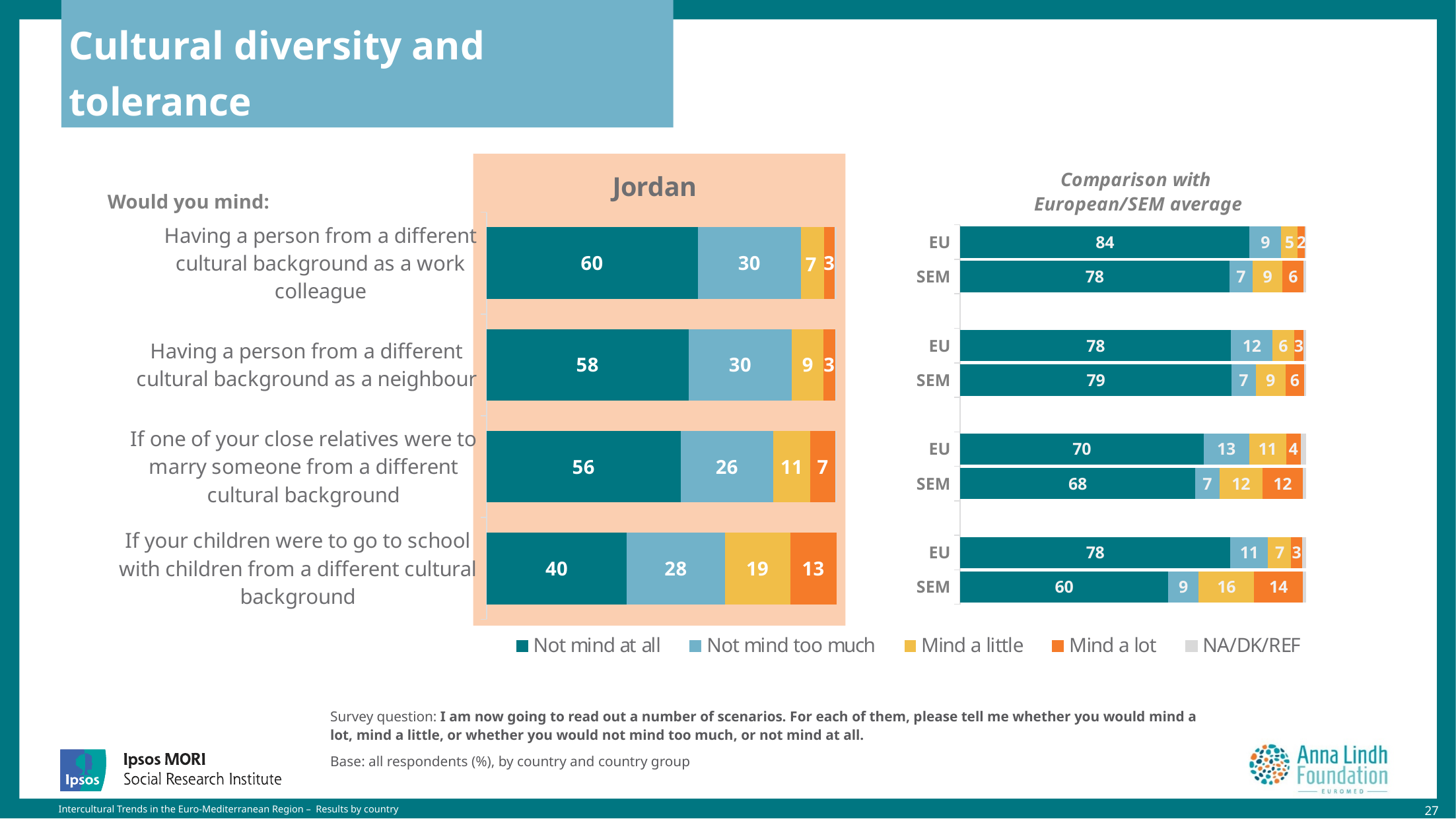
In the Jordan chart, what is the difference between the 'Not mind at all' values for the work colleague scenario and the children at school scenario? 20 In the Jordan chart, which scenario has the highest 'Not mind at all' value? Having a person from a different cultural background as a work colleague How many series does the legend list? 5 In the Jordan chart, what percentage would 'Not mind at all' having a person from a different cultural background as a work colleague? 60 In the Comparison with European/SEM average chart, what is the difference between the EU and SEM 'Not mind at all' values for the work colleague scenario? 6 What kind of chart is the Jordan chart? Stacked bar chart In the Jordan chart, which scenario has the lowest 'Not mind at all' value? If your children were to go to school with children from a different cultural background In the Jordan chart, what is the 'Mind a lot' value for children going to school with children from a different cultural background? 13 How many scenarios are shown in the Jordan chart? 4 In the Comparison with European/SEM average chart, what is the EU 'Not mind at all' value for the work colleague scenario? 84 In the Comparison with European/SEM average chart, for the children at school scenario, is the 'Mind a lot' value larger for EU or SEM? SEM In the Jordan chart, is the 'Mind a little' value larger for the close relative marrying scenario or the neighbour scenario? Close relative marrying scenario